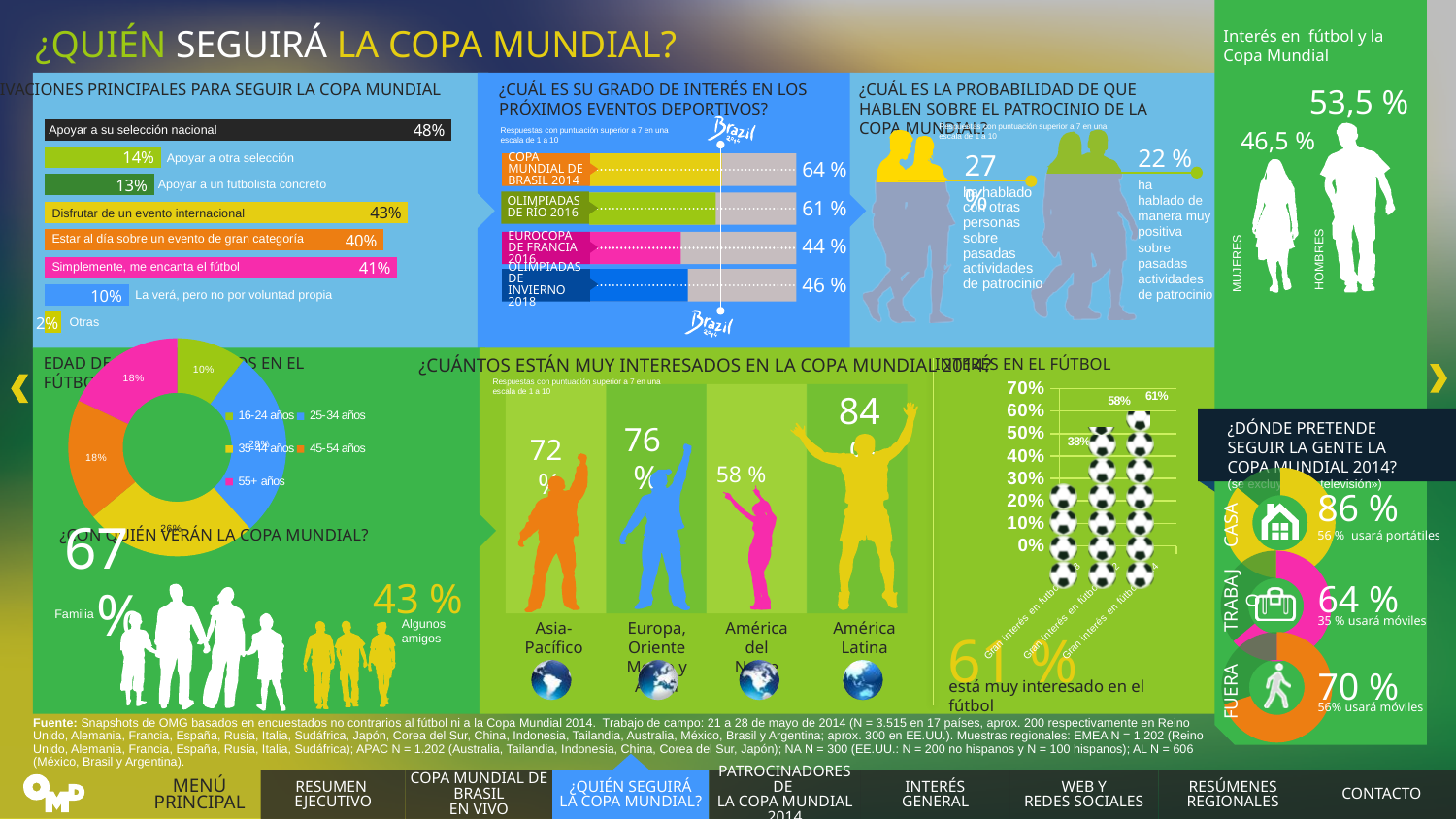
In the chart 'Motivaciones principales para seguir la Copa Mundial', what is the difference between 'Disfrutar de un evento internacional' and 'Estar al día sobre un evento de gran categoría'? 3% In the chart '¿Cuántos están muy interesados en la Copa Mundial?', what percentage is shown for 'América del Norte'? 58 % In the chart '¿Dónde pretende seguir la gente la Copa Mundial 2014?', what percentage is shown for 'Casa'? 86 % In the chart 'Interés en fútbol y la Copa Mundial', which group has the higher percentage, Mujeres or Hombres? Hombres In the chart '¿Cuál es su grado de interés en los próximos eventos deportivos?', which event has the lowest interest? Eurocopa de Francia 2016 In the chart '¿Cuántos están muy interesados en la Copa Mundial?', what is the difference between América Latina and Asia-Pacífico? 12 % In the chart 'Motivaciones principales para seguir la Copa Mundial', which motivation has the lowest percentage? Otras In the chart 'Motivaciones principales para seguir la Copa Mundial', what percentage is shown for 'Apoyar a su selección nacional'? 48% In the chart '¿Con quién verán la Copa Mundial?', what percentage is shown for 'Familia'? 67 % In the chart '¿Cuántos están muy interesados en la Copa Mundial?', which region has the highest percentage? América Latina In the chart '¿Cuál es su grado de interés en los próximos eventos deportivos?', how many events are listed? 4 In the chart '¿Cuál es su grado de interés en los próximos eventos deportivos?', what percentage is shown for 'Copa Mundial de Brasil 2014'? 64 %